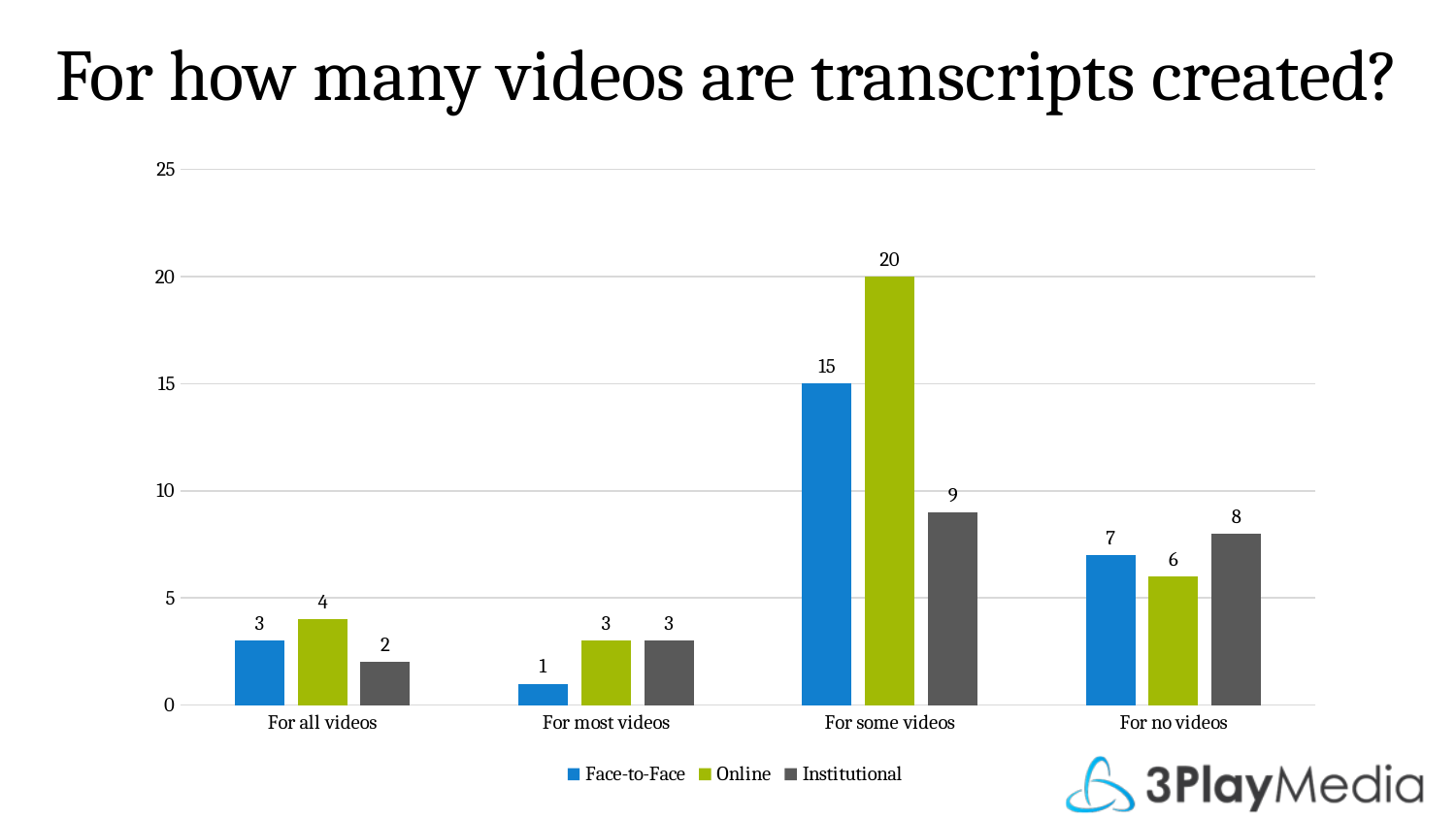
Is the Face-to-Face value for "For some videos" greater or less than 10? greater How many categories are shown on the x axis? 4 Which category has the highest Face-to-Face value? For some videos What is the difference between the Online and Institutional values for "For some videos"? 11 What kind of chart is shown on the slide? Bar chart How many series does the legend list? 3 Which category has the lowest Institutional value? For all videos For "For no videos", which is larger: the Face-to-Face value or the Online value? Face-to-Face Which series is shown in green in the legend? Online What is the Face-to-Face value for "For most videos"? 1 What is the Online value for "For some videos"? 20 What is the Institutional value for "For no videos"? 8